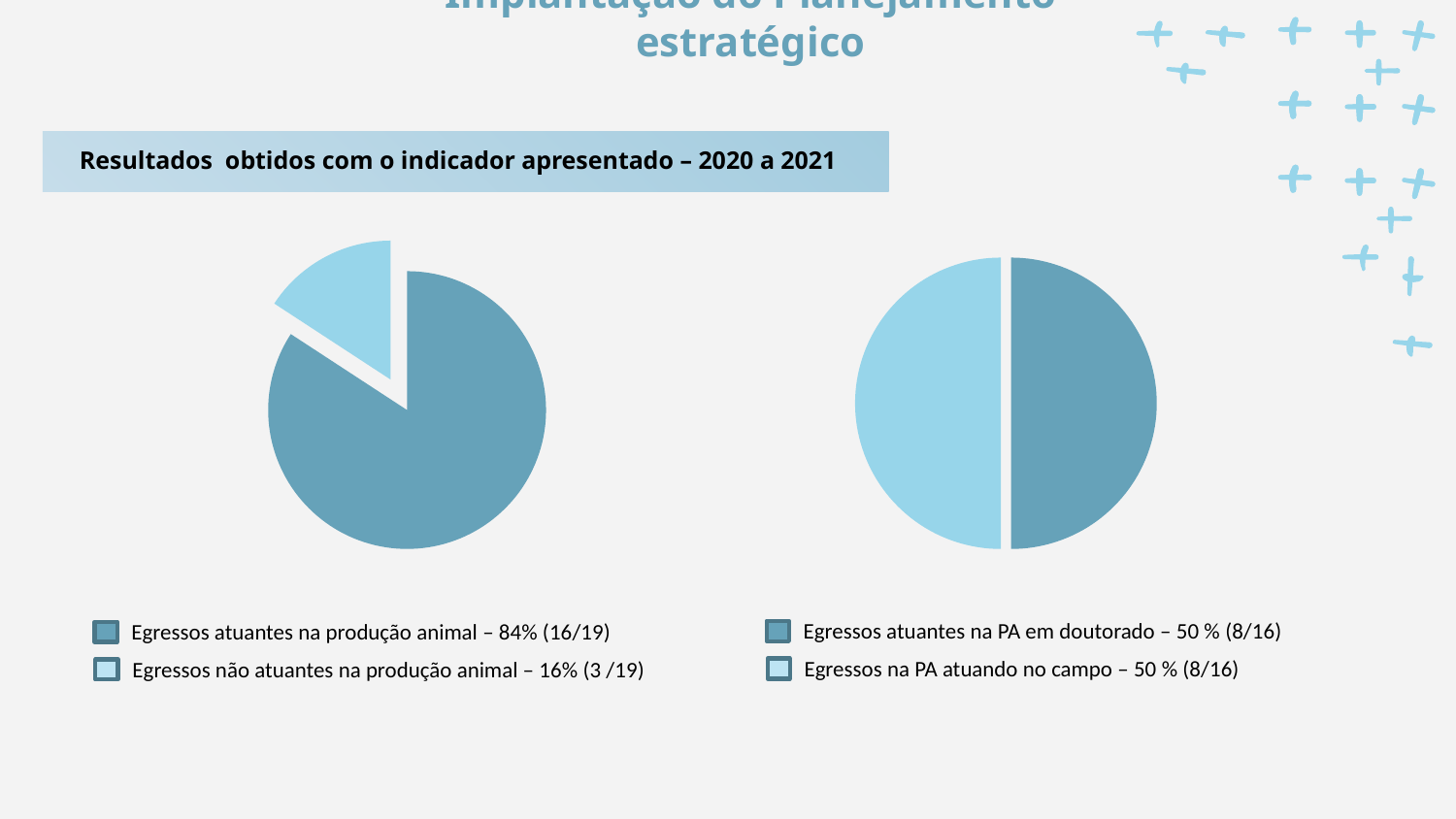
How many slices does the left pie chart have? 2 In the left pie chart, what share is shown for 'Egressos atuantes na produção animal'? 84% In the left pie chart, which category has the smallest slice? Egressos não atuantes na produção animal In the left pie chart, which category has the largest slice? Egressos atuantes na produção animal In the left pie chart, what is the difference in percentage points between the two slices? 68 In the left pie chart, how many egressos are counted as 'atuantes na produção animal' according to the legend? 16 In the right pie chart, what share is shown for 'Egressos atuantes na PA em doutorado'? 50 % In the left pie chart, what share is shown for 'Egressos não atuantes na produção animal'? 16% How many categories does the legend of the right pie chart list? 2 What is the text of the heading above the two pie charts? Resultados obtidos com o indicador apresentado – 2020 a 2021 What kind of chart is the left chart on the slide? pie chart In the right pie chart, how many egressos are counted as 'na PA atuando no campo' according to the legend? 8